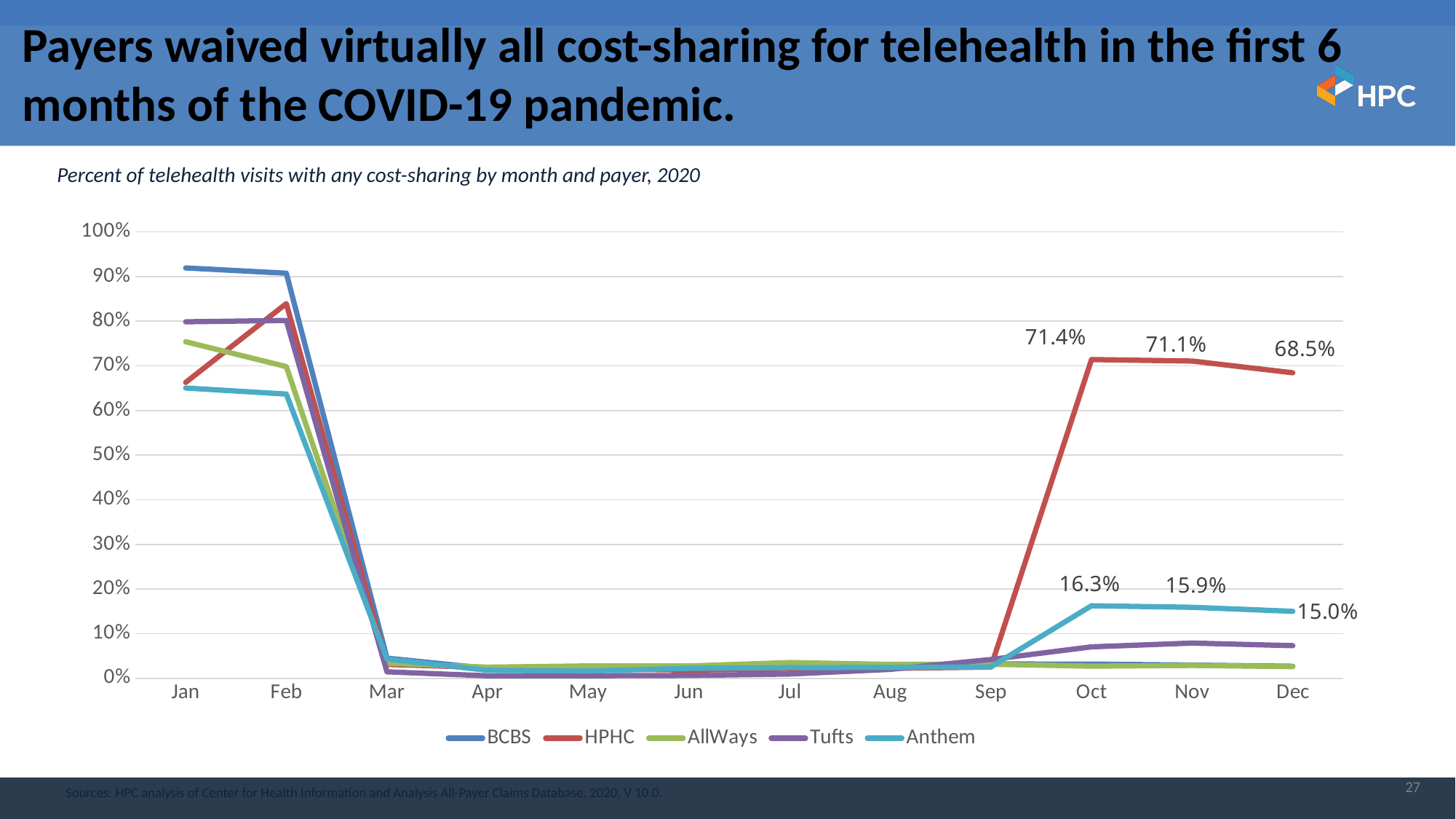
What is the difference between the HPHC value in October and the HPHC value in December? 2.9% What type of chart is shown on the slide? Line chart What is the difference between the HPHC value and the Anthem value in October? 55.1% What is the value for HPHC in October? 71.4% What is the value for HPHC in December? 68.5% What is the value for Anthem in November? 15.9% Which payer has the highest value in January? BCBS Which is larger in February: the value for HPHC or the value for AllWays? HPHC How many months are shown on the x axis? 12 What is the value for Anthem in December? 15.0% Is the value for BCBS in January greater or less than 90%? greater How many series does the legend list? 5